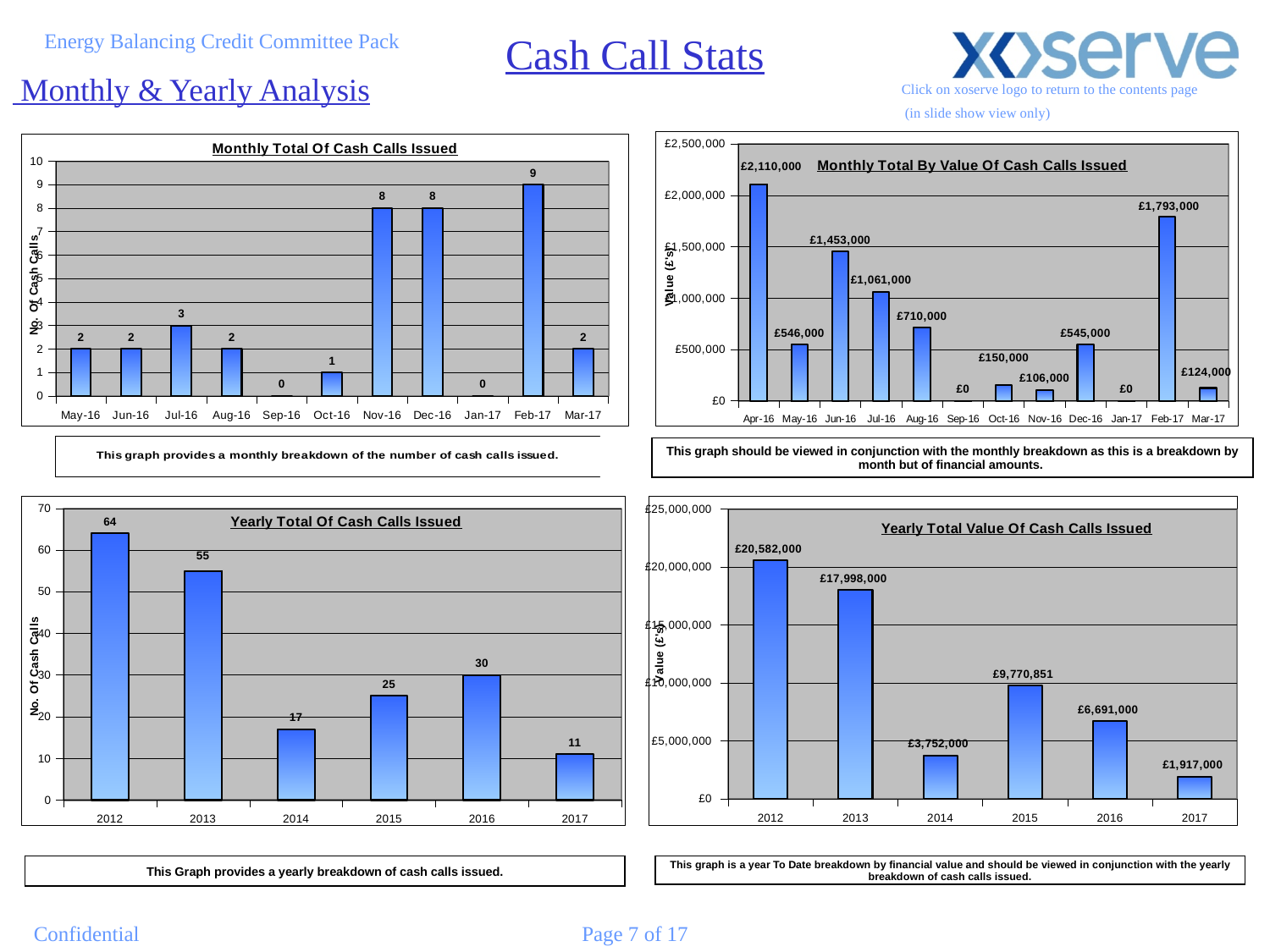
In the 'Monthly Total Of Cash Calls Issued' chart, which month has the highest number of cash calls? Feb-17 In the 'Yearly Total Value Of Cash Calls Issued' chart, what is the value for 2015? £9,770,851 What type of chart is the 'Yearly Total Value Of Cash Calls Issued' chart? Bar chart In the 'Yearly Total Of Cash Calls Issued' chart, how many cash calls were issued in 2015? 25 In the 'Monthly Total Of Cash Calls Issued' chart, how many cash calls were issued in Feb-17? 9 In the 'Monthly Total By Value Of Cash Calls Issued' chart, what is the difference between the values for Feb-17 and Mar-17? £1,669,000 In the 'Monthly Total By Value Of Cash Calls Issued' chart, what is the value for Jun-16? £1,453,000 In the 'Yearly Total Of Cash Calls Issued' chart, which year has the lowest total? 2017 In the 'Yearly Total Of Cash Calls Issued' chart, what is the difference between the totals for 2012 and 2013? 9 In the 'Monthly Total By Value Of Cash Calls Issued' chart, which month has the highest value? Apr-16 In the 'Monthly Total Of Cash Calls Issued' chart, how many months are shown on the x axis? 11 In the 'Yearly Total Value Of Cash Calls Issued' chart, which is larger, the value for 2014 or the value for 2016? 2016